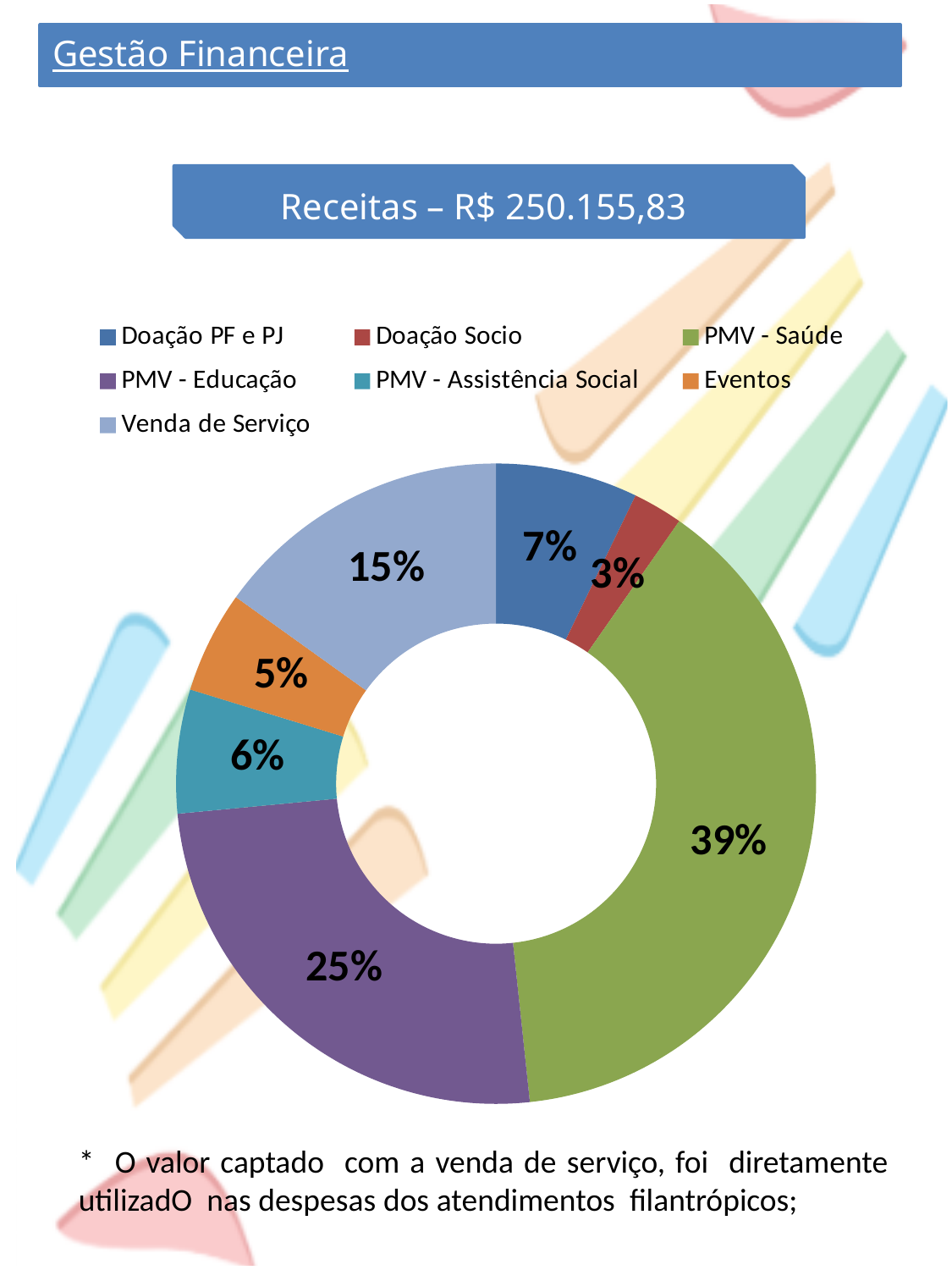
What percentage is shown for Doação Socio? 3% What is the difference in percentage points between PMV - Saúde and PMV - Educação? 14 What percentage is shown for PMV - Educação? 25% What share of receipts does PMV - Saúde account for? 39% What total amount of receipts is stated in the banner above the chart? R$ 250.155,83 What percentage is shown for Venda de Serviço? 15% What is the combined share of Doação PF e PJ and Doação Socio? 10% Which category has the largest share of the chart? PMV - Saúde Which category has the smallest share of the chart? Doação Socio Which is larger, the share for Eventos or the share for PMV - Assistência Social? PMV - Assistência Social What kind of chart is shown on the slide? Doughnut chart How many categories are shown in the chart? 7